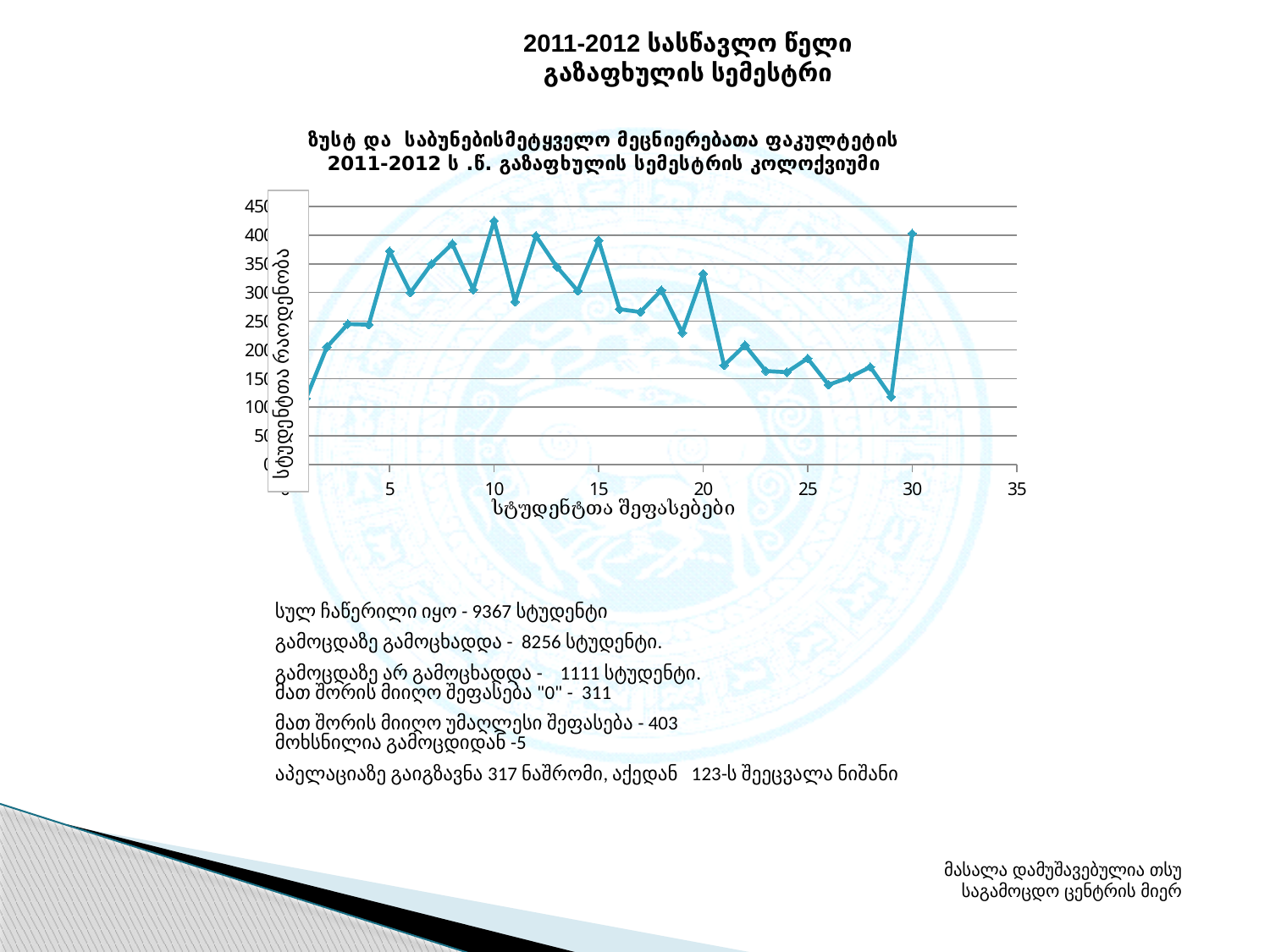
Which is larger, the value at x = 5 or the value at x = 6? x = 5 What is the label on the vertical axis of the chart? სტუდენტთა რაოდენობა Is the value at x = 25 greater or less than 200? less At which x-axis value does the line reach its highest point? 10 Do the values generally rise or fall between x = 1 and x = 5? rise Which is larger, the value at x = 20 or the value at x = 21? x = 20 Is the value at x = 5 greater or less than 350? greater Is the value at x = 29 greater or less than 150? less What kind of chart is shown on the slide? line chart What is the highest tick value shown on the vertical axis? 450